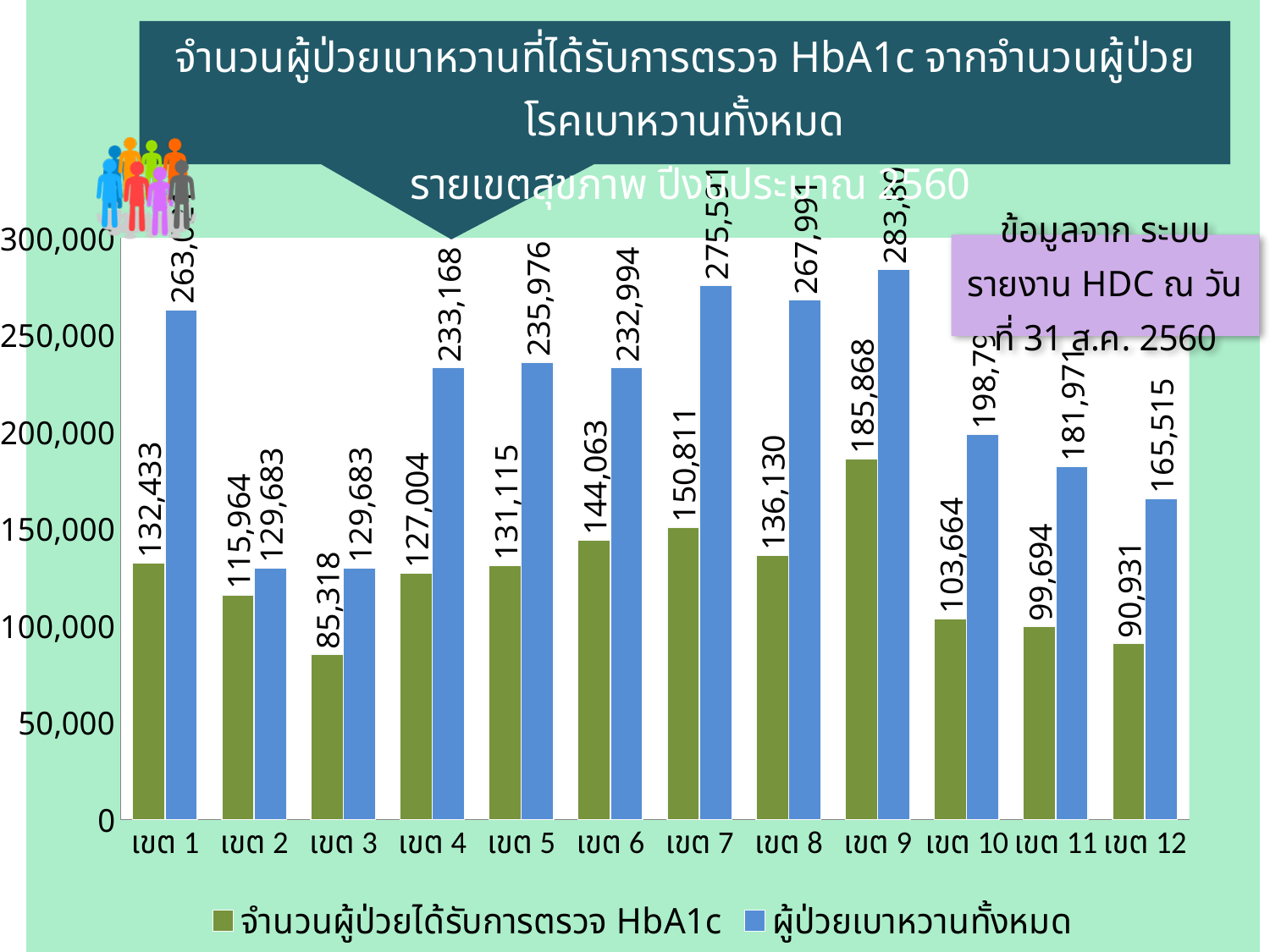
What is the value of ผู้ป่วยเบาหวานทั้งหมด for เขต 5? 235,976 What is the difference between ผู้ป่วยเบาหวานทั้งหมด and จำนวนผู้ป่วยได้รับการตรวจ HbA1c for เขต 4? 106,164 Is the value of ผู้ป่วยเบาหวานทั้งหมด for เขต 1 greater or less than 250,000? greater What type of chart is shown on the slide? bar chart How many series does the legend list? 2 Which region has the highest value for จำนวนผู้ป่วยได้รับการตรวจ HbA1c? เขต 9 What is the value of จำนวนผู้ป่วยได้รับการตรวจ HbA1c for เขต 3? 85,318 Which region has the lowest value for จำนวนผู้ป่วยได้รับการตรวจ HbA1c? เขต 3 Which colour represents ผู้ป่วยเบาหวานทั้งหมด in the chart? blue What is the value of จำนวนผู้ป่วยได้รับการตรวจ HbA1c for เขต 9? 185,868 Which has a larger value for จำนวนผู้ป่วยได้รับการตรวจ HbA1c, เขต 5 or เขต 6? เขต 6 How many health regions (เขต) are shown on the x axis? 12